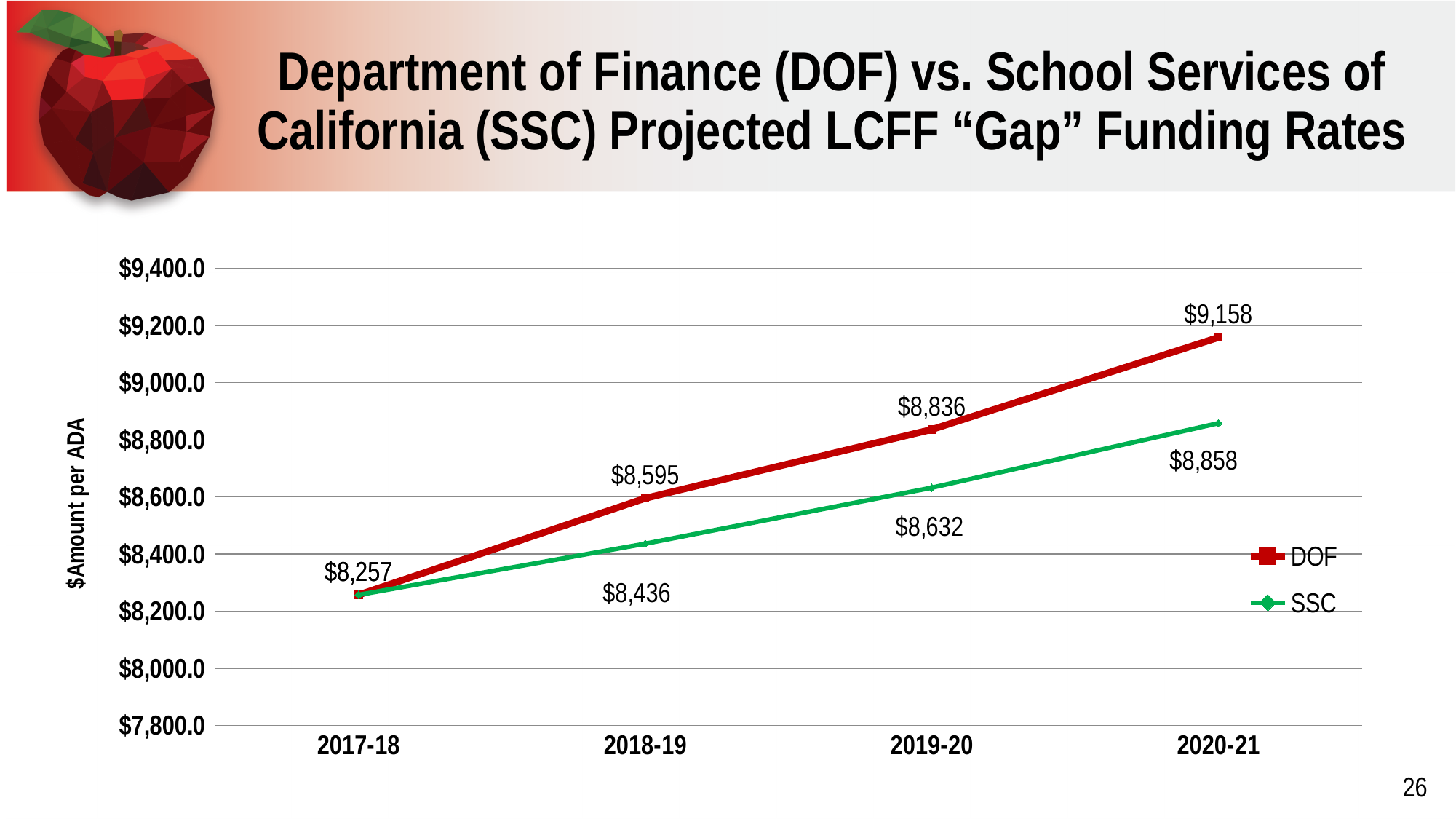
What is the DOF projected value for 2020-21? $9,158 What is the difference between the DOF and SSC values in 2019-20? $204 What kind of chart is shown on the slide? Line chart In which year is the DOF series at its lowest value? 2017-18 How many series does the legend list? 2 Which series has the larger value in 2018-19, DOF or SSC? DOF What is the DOF projected value for 2018-19? $8,595 What is the difference between the DOF and SSC values in 2020-21? $300 How many years are shown on the x axis? 4 What is the SSC projected value for 2019-20? $8,632 In which year does the DOF series reach its highest value? 2020-21 What is the SSC projected value for 2020-21? $8,858